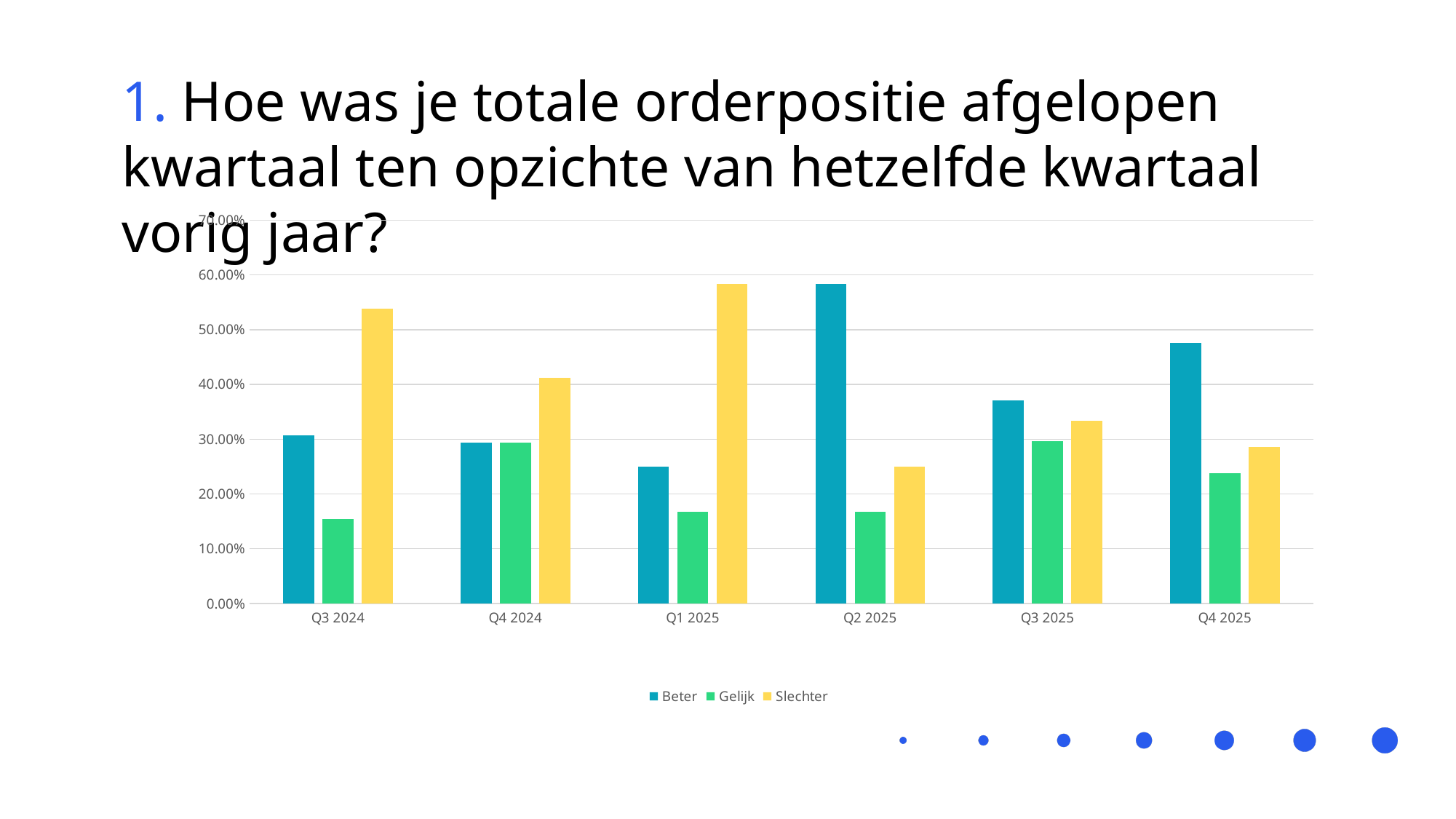
Which series are listed in the legend? Beter, Gelijk, Slechter Is the Slechter value for Q3 2024 greater or less than 50.00%? greater What kind of chart is shown on the slide? bar chart Is the Beter value for Q2 2025 greater or less than 50.00%? greater How many quarters are shown on the x axis? 6 In which quarter is the Slechter value lowest? Q2 2025 In which quarter is the Slechter value highest? Q1 2025 In Q2 2025, which is larger: Beter or Slechter? Beter Is the Gelijk value for Q3 2024 greater or less than 20.00%? less In which quarter is the Beter value highest? Q2 2025 Does the Beter value rise or fall from Q1 2025 to Q2 2025? rise How many series does the legend list? 3